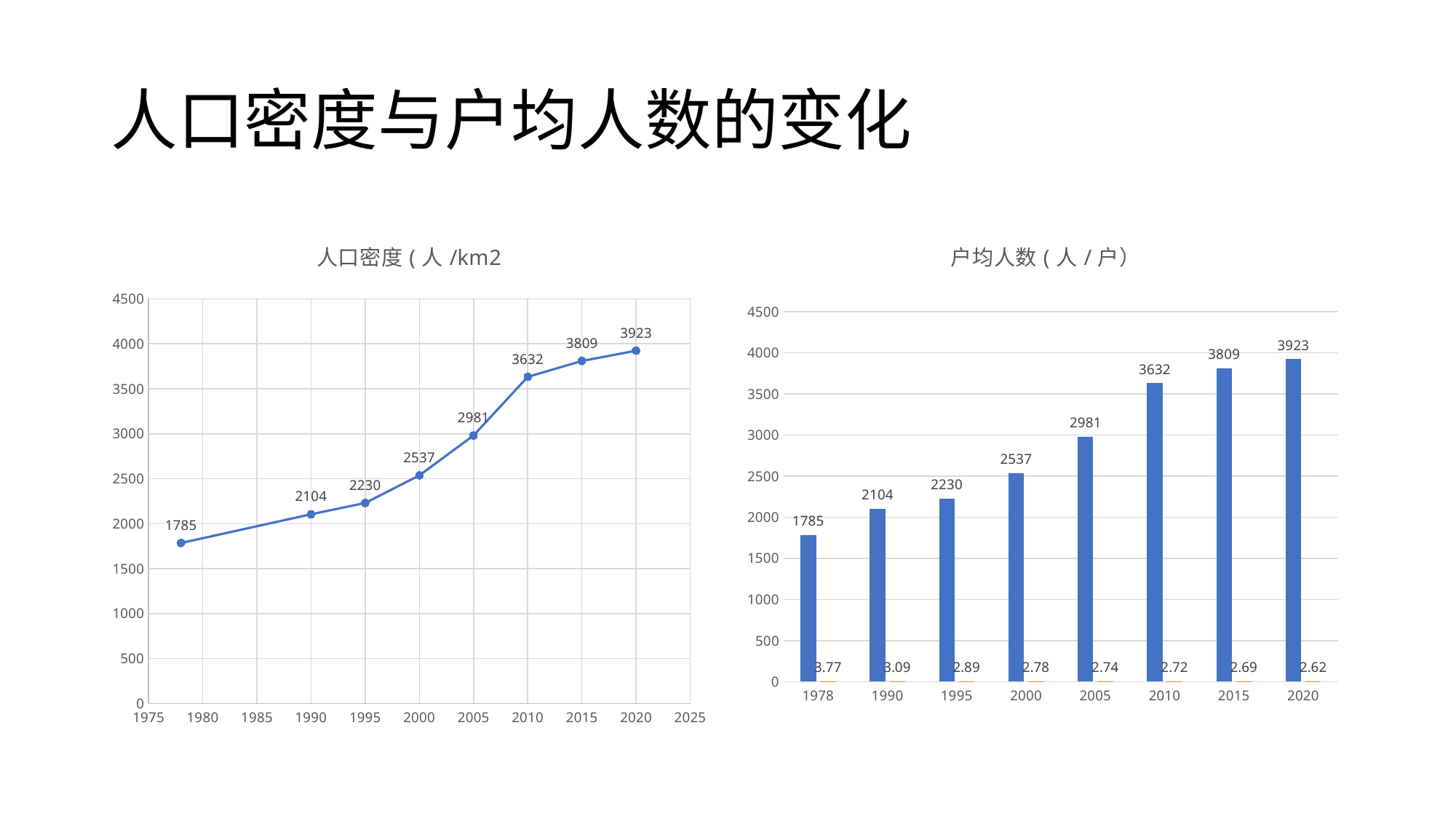
In the right chart titled 户均人数（人/户）, what is the small orange-bar value labelled for 1978? 3.77 In the left chart titled 人口密度（人/km2）, which year has the highest value? 2020 In the left chart titled 人口密度（人/km2）, what is the value for 2010? 3632 In the left chart titled 人口密度（人/km2）, what is the difference between the values for 2010 and 2005? 651 In the right chart titled 户均人数（人/户）, what is the value of the blue bar for 1995? 2230 In the left chart titled 人口密度（人/km2）, do the values rise or fall from left to right along the x axis? rise In the right chart titled 户均人数（人/户）, what is the small orange-bar value labelled for 2020? 2.62 What kind of chart is the right chart titled 户均人数（人/户）? bar chart How many data points are plotted in the left chart titled 人口密度（人/km2）? 8 What kind of chart is the left chart titled 人口密度（人/km2）? line chart In the left chart titled 人口密度（人/km2）, what is the value for 2000? 2537 In the right chart titled 户均人数（人/户）, which year has the lowest blue bar? 1978